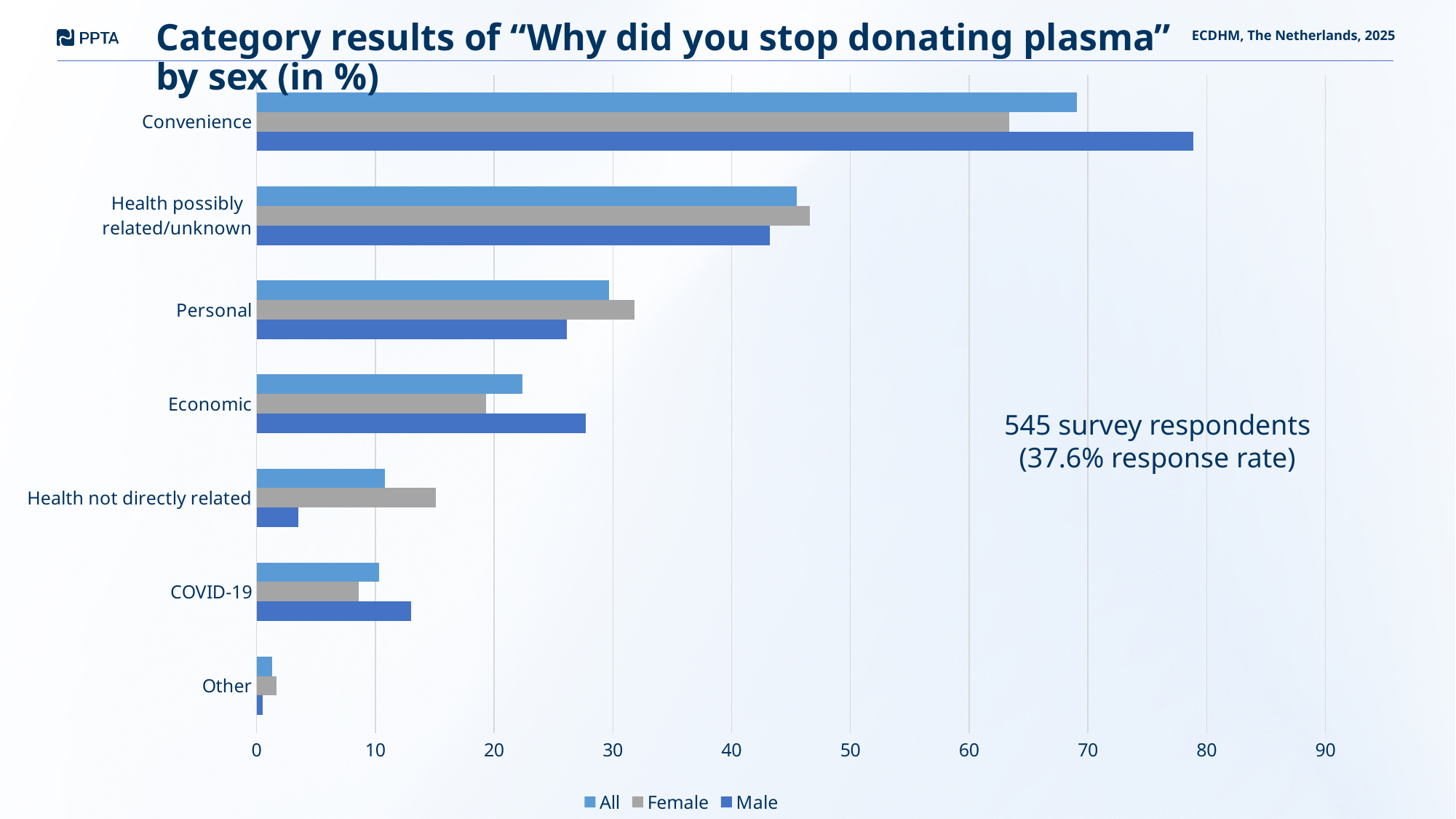
Is the Male value for Convenience greater or less than 70? greater How many categories (reasons for stopping) are shown on the chart? 7 How many survey respondents does the slide report? 545 What kind of chart is shown on the slide? Bar chart Is the Male value for Health not directly related greater or less than 10? less What are the three series listed in the legend? All, Female, Male Is the Female value for Health not directly related greater or less than 10? greater Which category has the lowest value for the Female series? Other For the Health not directly related category, which is larger: the Female value or the Male value? Female Which category has the highest value for the Male series? Convenience How many series does the legend list? 3 For the Economic category, which is larger: the Male value or the Female value? Male